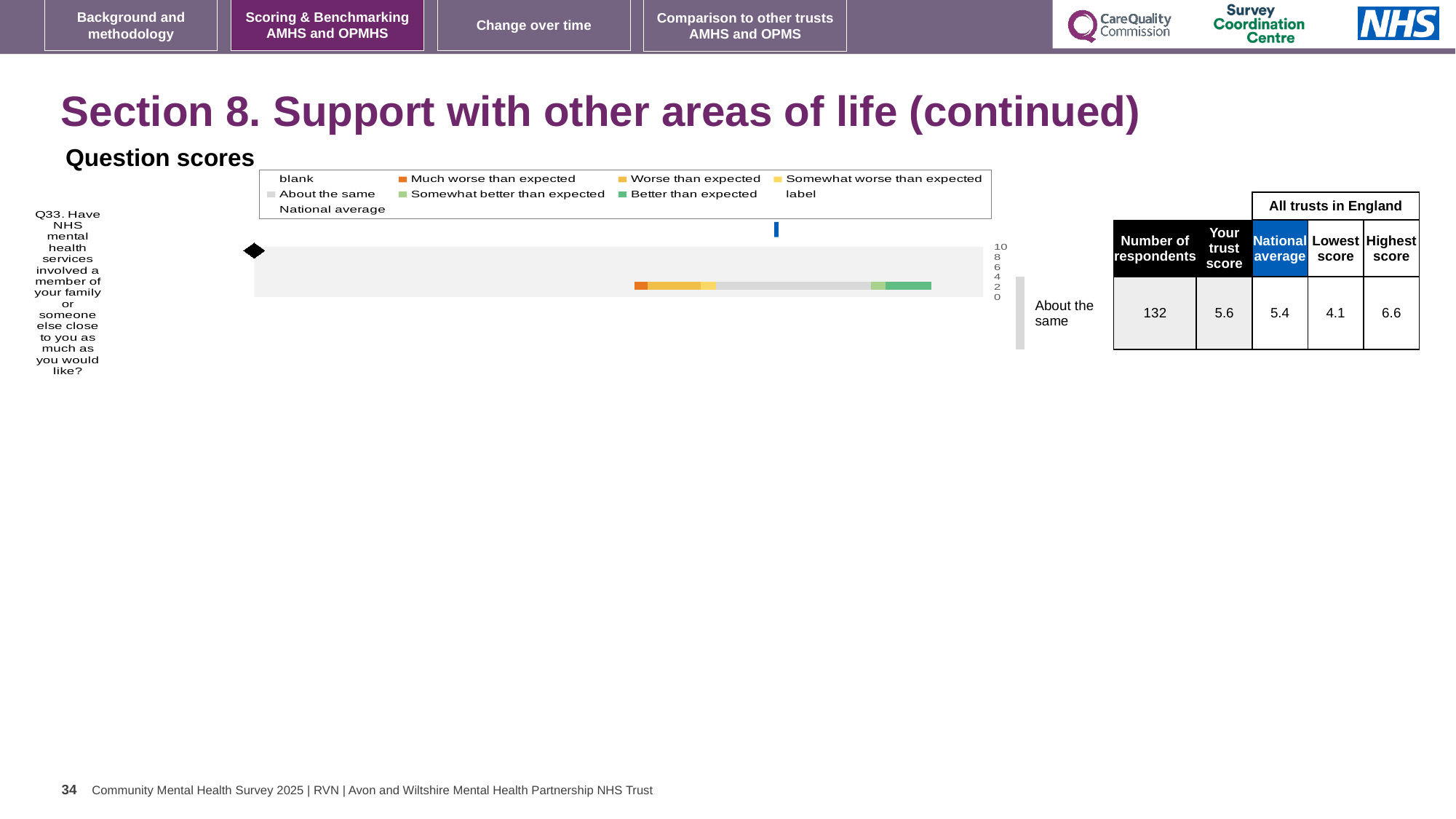
How many questions are plotted in the Question scores chart? 1 What is the difference between the highest score and the lowest score for Q33? 2.5 What is the national average score for Q33 shown next to the Question scores chart? 5.4 In the legend of the Question scores chart, what colour represents 'Much worse than expected'? orange In the legend of the Question scores chart, what colour represents 'Better than expected'? green What is the trust score for Q33 shown next to the Question scores chart? 5.6 For Q33, which is larger: the trust score or the national average? the trust score How many respondents answered Q33 according to the table beside the Question scores chart? 132 What is the lowest score among all trusts in England for Q33? 4.1 What kind of chart is shown under 'Question scores'? bar chart What is the highest score among all trusts in England for Q33? 6.6 How many entries does the legend of the Question scores chart list? 9